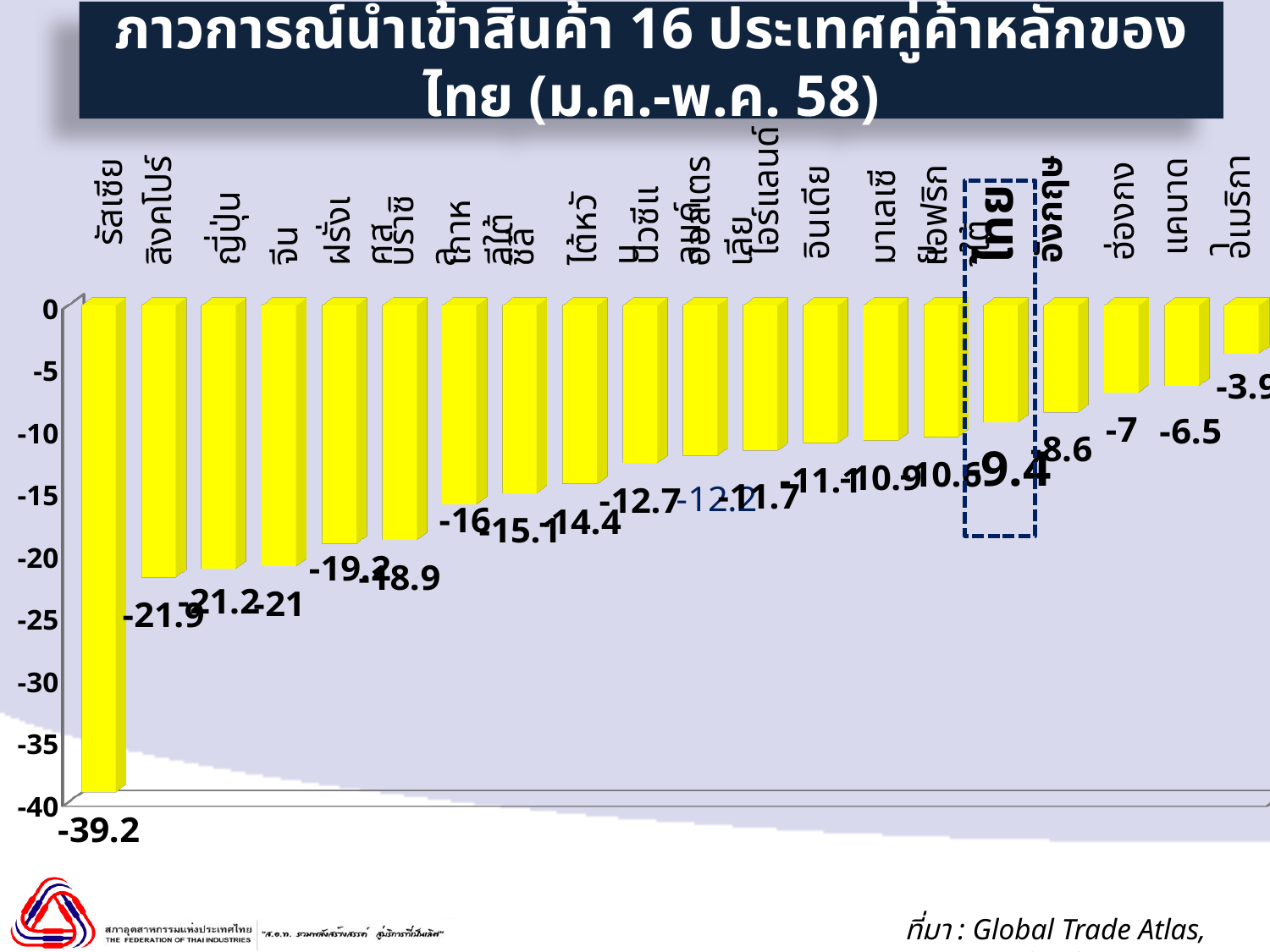
What is the value shown for ไทย? -9.4 Which has the lower value, รัสเซีย or ไทย? รัสเซีย What is the value shown for แคนาดา? -6.5 Do the values rise or fall moving from left to right along the x axis? rise What is the value shown for รัสเซีย? -39.2 What kind of chart is shown on the slide? bar chart What is the value shown for ฝรั่งเศส? -19.2 What is the difference between the values for รัสเซีย (-39.2) and สิงคโปร์ (-21.9)? 17.3 Which country's bar is highlighted with a dashed box? ไทย What is the value shown for ฮ่องกง? -7 Which country has the lowest (most negative) value in the chart? รัสเซีย What is the value shown for สิงคโปร์? -21.9